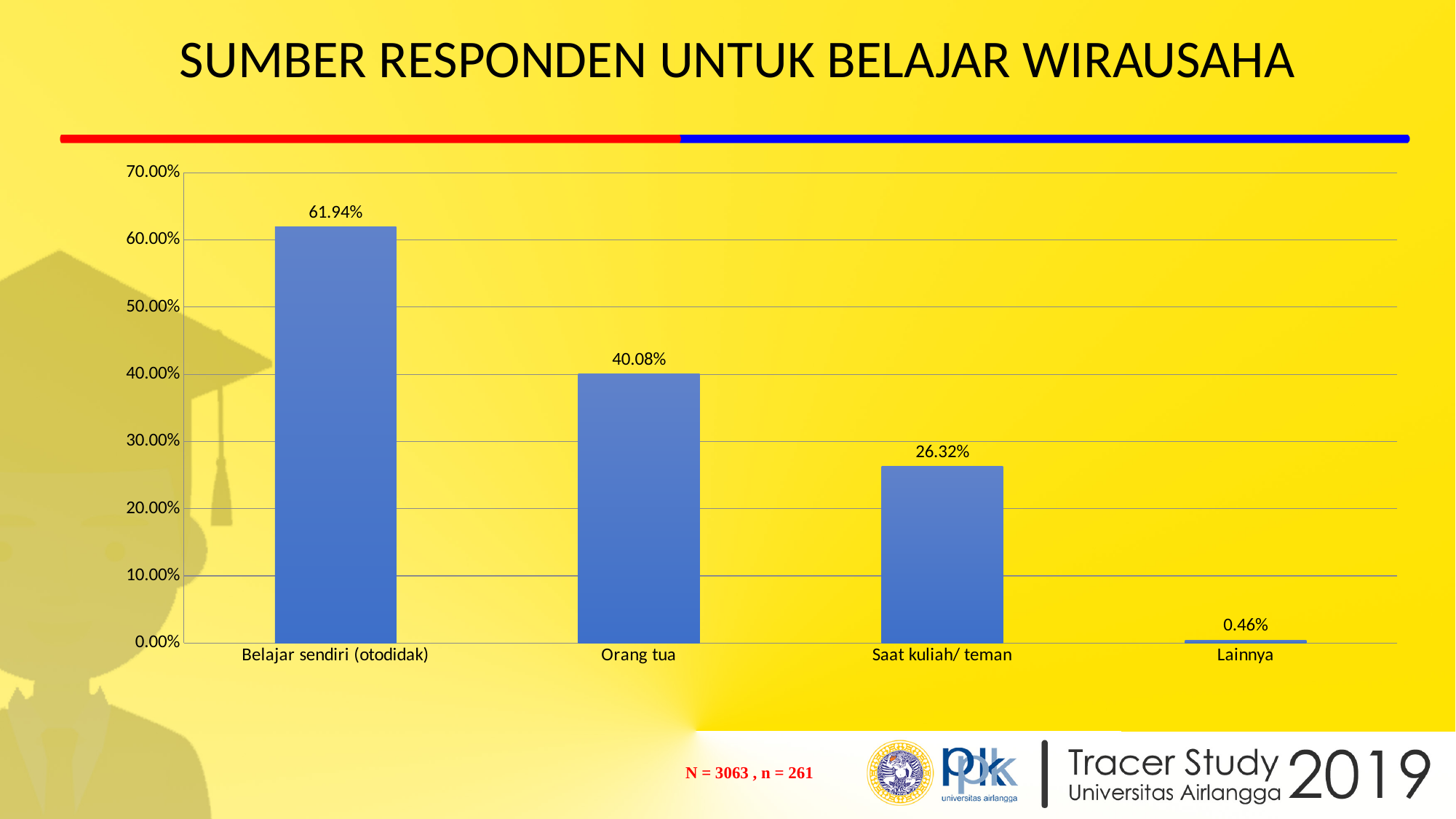
What is the value for Belajar sendiri (otodidak)? 61.94% Which category has the lowest value? Lainnya Is the value for Saat kuliah/ teman greater or less than 30.00%? less Which is larger, the value for Orang tua or the value for Saat kuliah/ teman? Orang tua What is the value for Lainnya? 0.46% How many categories are shown on the x axis? 4 Which category has the highest value? Belajar sendiri (otodidak) What is the difference between the values for Orang tua and Saat kuliah/ teman? 13.76% What kind of chart is shown on the slide? Bar chart What is the difference between the values for Belajar sendiri (otodidak) and Orang tua? 21.86% What is the value for Saat kuliah/ teman? 26.32% What is the value for Orang tua? 40.08%